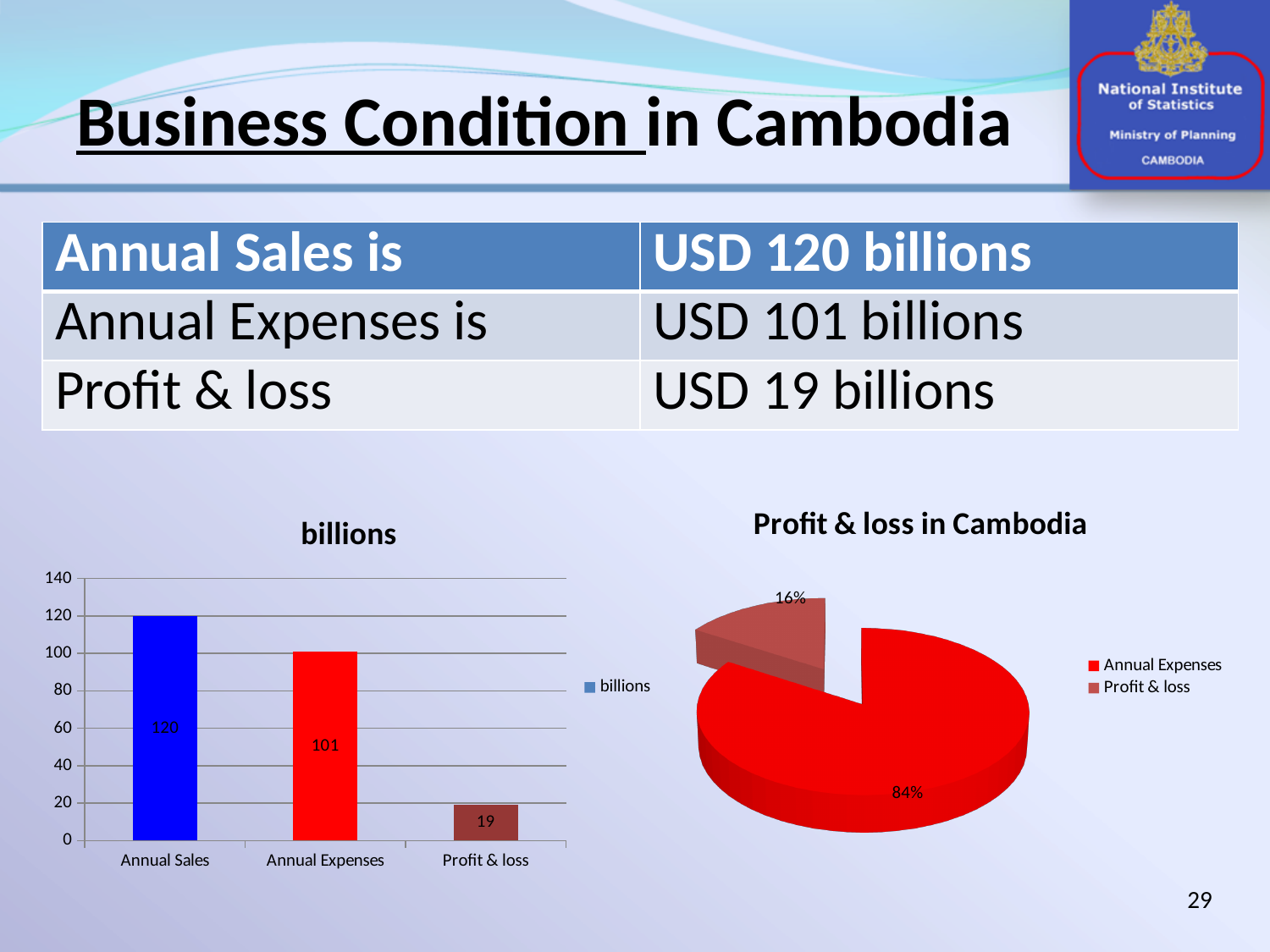
In the pie chart titled "Profit & loss in Cambodia", what share does Profit & loss have? 16% In the bar chart titled "billions", what is the difference between Annual Sales and Annual Expenses? 19 In the pie chart titled "Profit & loss in Cambodia", what share does Annual Expenses have? 84% In the bar chart titled "billions", which category has the lowest value? Profit & loss In the bar chart titled "billions", what is the value for Annual Sales? 120 In the bar chart titled "billions", what is the value for Annual Expenses? 101 How many categories are shown in the bar chart titled "billions"? 3 In the bar chart titled "billions", what is the value for Profit & loss? 19 In the bar chart titled "billions", is the value for Annual Expenses greater or less than 100? greater How many series does the legend of the pie chart titled "Profit & loss in Cambodia" list? 2 In the bar chart titled "billions", which category has the highest value? Annual Sales What kind of chart is the chart titled "billions"? bar chart